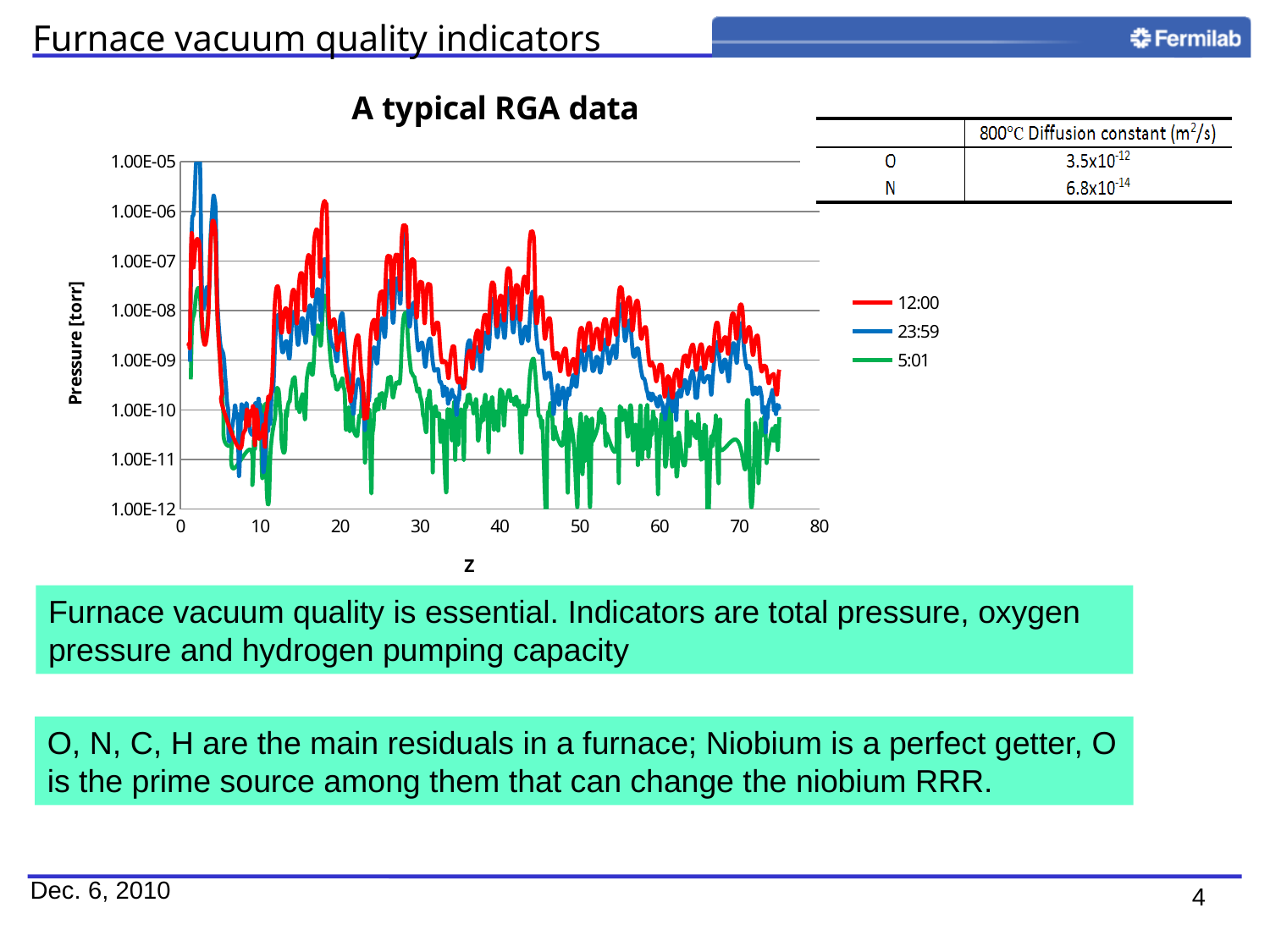
Which series generally has the highest pressure values across the chart: 12:00, 23:59 or 5:01? 12:00 What is the highest tick value shown on the vertical axis of the chart? 1.00E-05 Is the value of the 5:01 series at z = 40 greater or less than 1.00E-08? less Is the value of the 12:00 series at z = 70 greater or less than 1.00E-10? greater What is the largest value shown on the horizontal (z) axis of the chart? 80 What is the label of the vertical axis of the chart? Pressure [torr] Which series is drawn in red in the chart? 12:00 Which series generally has the lowest pressure values across the chart? 5:01 How many series does the chart legend list? 3 What kind of chart is shown on the slide? Line chart Is the peak value of the 12:00 series near z = 18 greater or less than 1.00E-07? greater What is the title of the chart? A typical RGA data